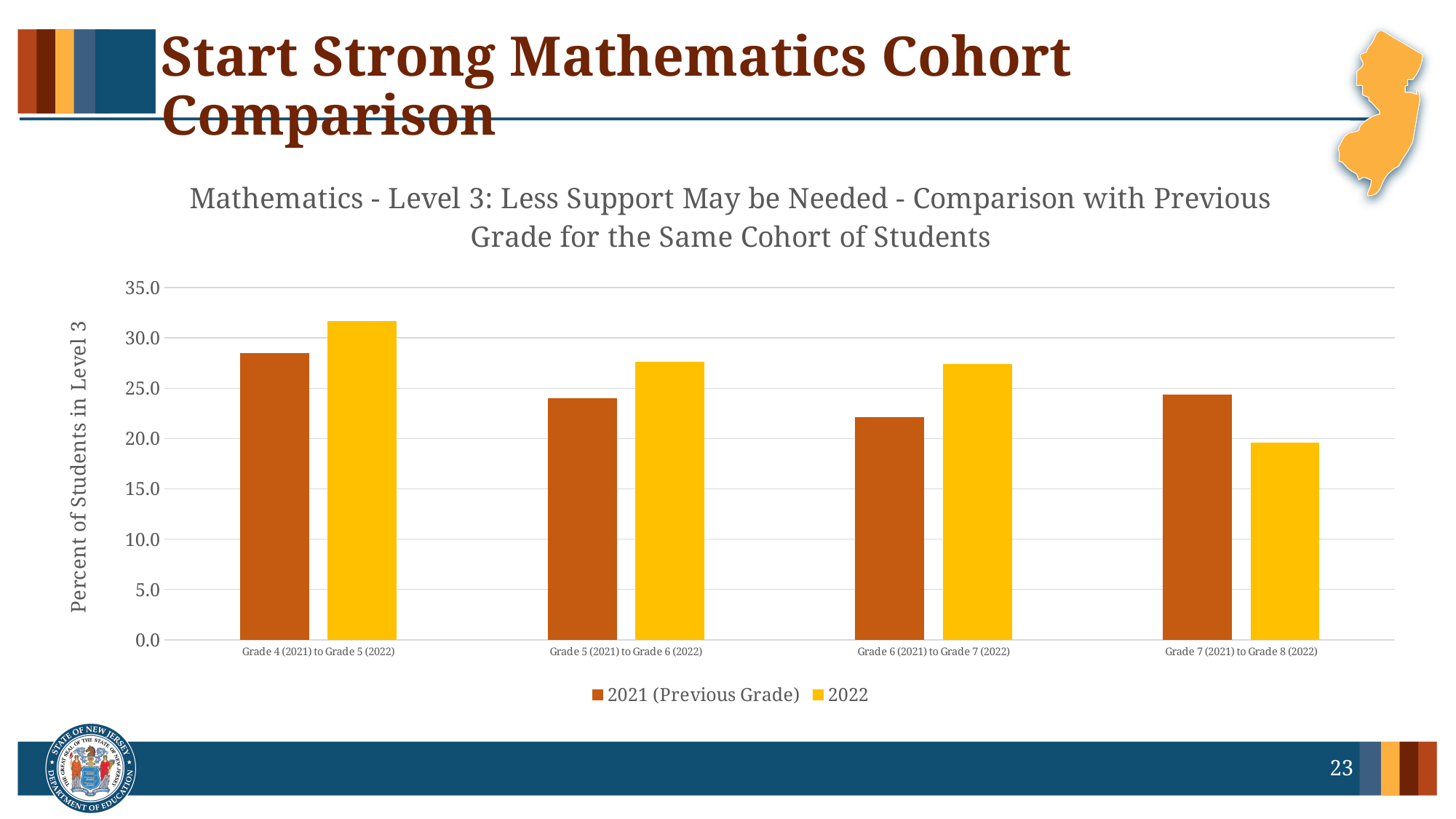
Which cohort has the lowest 2022 value? Grade 7 (2021) to Grade 8 (2022) Is the 2021 (Previous Grade) value for Grade 4 (2021) to Grade 5 (2022) greater or less than 25? greater Which cohort has the lowest 2021 (Previous Grade) value? Grade 6 (2021) to Grade 7 (2022) How many cohort categories are shown on the x axis? 4 Which cohort has the highest 2022 value? Grade 4 (2021) to Grade 5 (2022) Is the 2022 value for Grade 4 (2021) to Grade 5 (2022) greater or less than 30? greater What is the label of the y axis? Percent of Students in Level 3 How many series does the legend list? 2 For Grade 7 (2021) to Grade 8 (2022), which is larger: the 2021 (Previous Grade) value or the 2022 value? 2021 (Previous Grade) Is the 2022 value for Grade 7 (2021) to Grade 8 (2022) greater or less than 25? less For Grade 6 (2021) to Grade 7 (2022), which is larger: the 2021 (Previous Grade) value or the 2022 value? 2022 What kind of chart is shown on the slide? bar chart